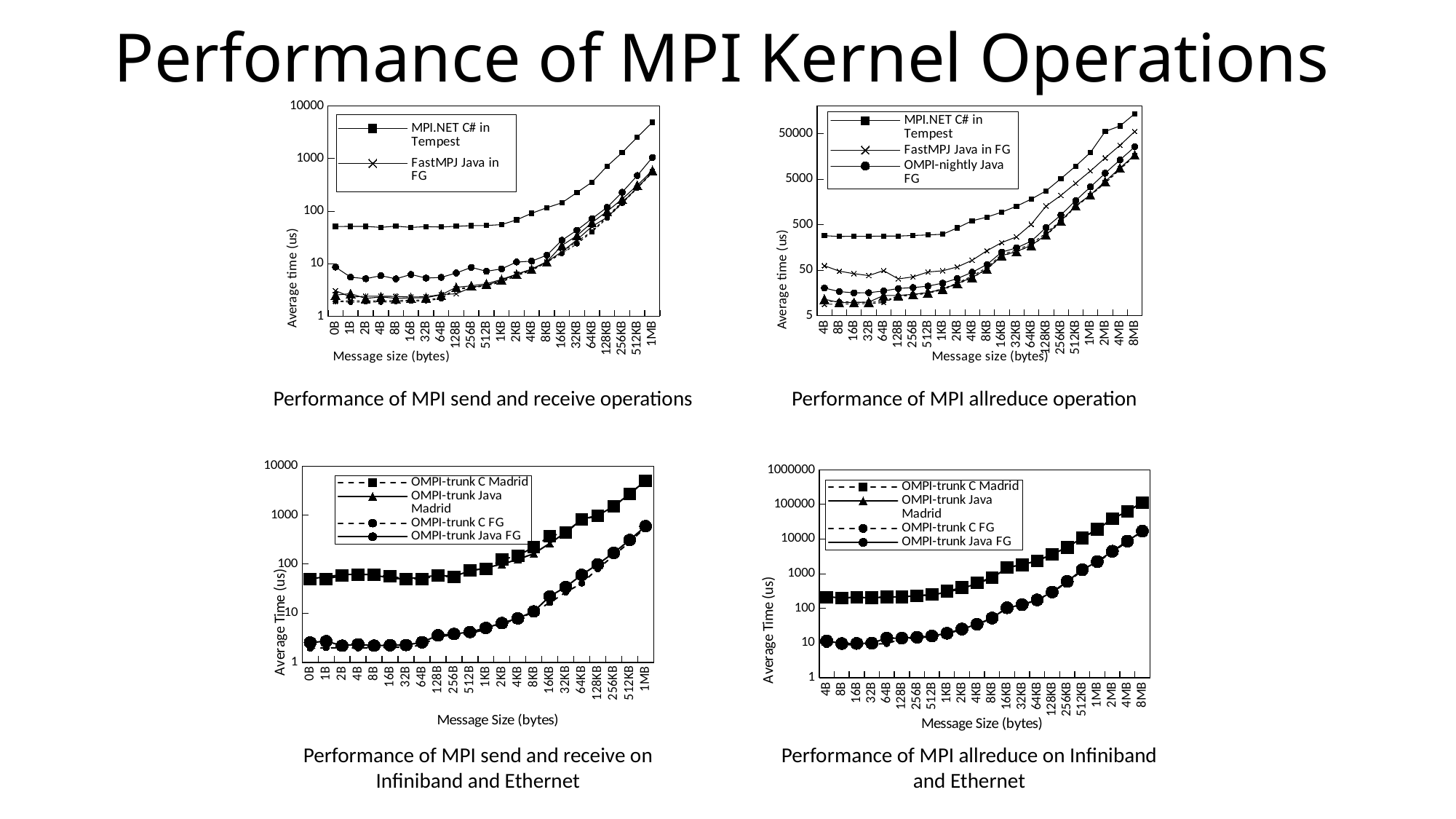
What kind of chart is the 'Performance of MPI send and receive on Infiniband and Ethernet' chart? line chart In the 'Performance of MPI send and receive operations' chart, do the values for MPI.NET C# in Tempest rise or fall as message size increases from 1KB to 1MB? rise In the 'Performance of MPI allreduce on Infiniband and Ethernet' chart, is the value for OMPI-trunk C FG at 8MB greater or less than 100000? less In the 'Performance of MPI send and receive on Infiniband and Ethernet' chart, how many series does the legend list? 4 In the 'Performance of MPI allreduce on Infiniband and Ethernet' chart, how many message sizes are shown on the x axis? 22 In the 'Performance of MPI send and receive on Infiniband and Ethernet' chart, is the value for OMPI-trunk C Madrid at 1MB greater or less than 1000? greater In the 'Performance of MPI send and receive on Infiniband and Ethernet' chart, which is larger at 1MB: OMPI-trunk C Madrid or OMPI-trunk C FG? OMPI-trunk C Madrid In the 'Performance of MPI send and receive on Infiniband and Ethernet' chart, is the value for OMPI-trunk C FG at 1MB greater or less than 1000? less What is the label of the y axis in the 'Performance of MPI allreduce on Infiniband and Ethernet' chart? Average Time (us)